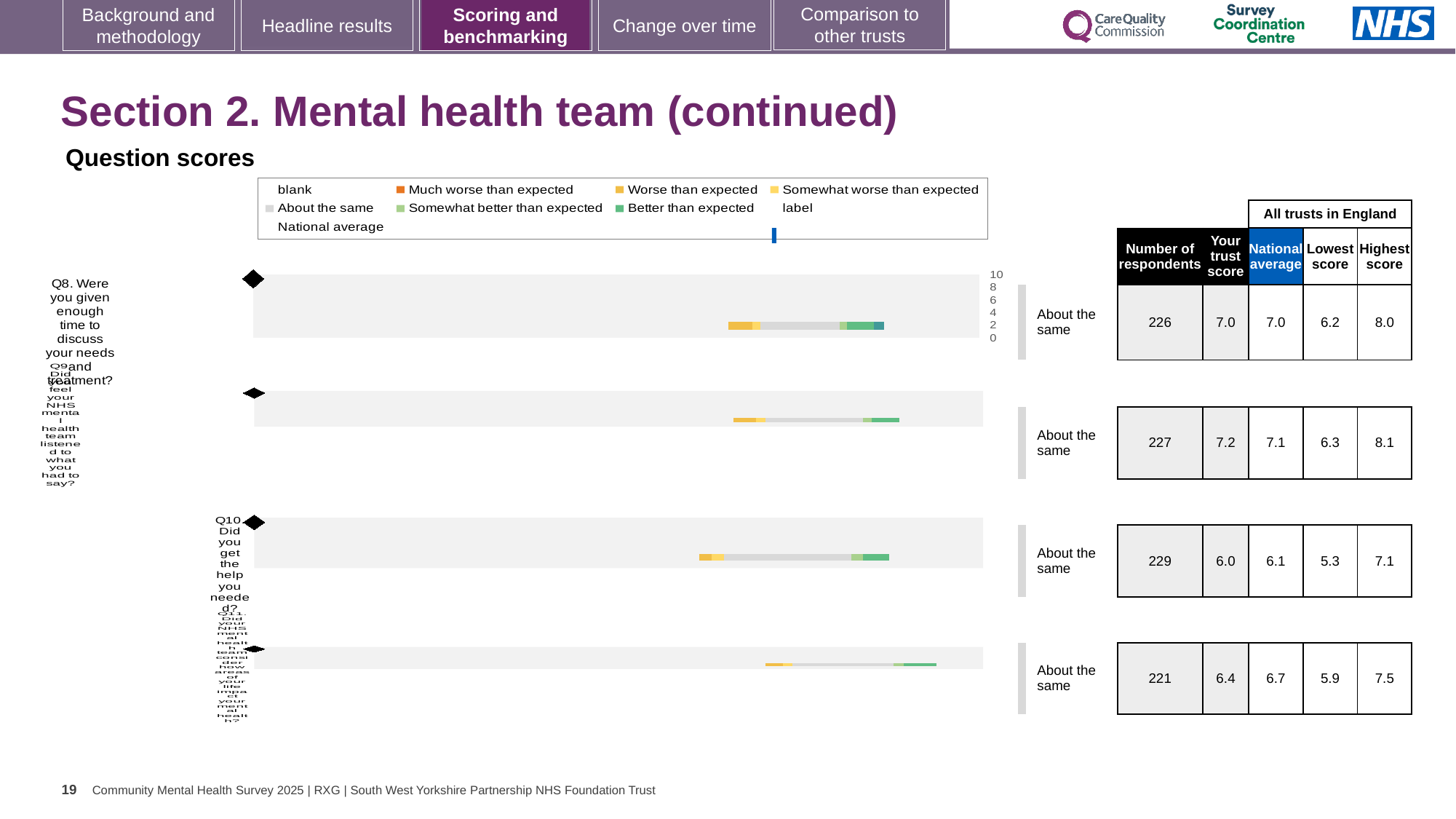
How many question rows are charted on this slide? 4 What is the highest score among all trusts in England for Q11 (the bottom chart row)? 7.5 Which question row has the lowest 'Your trust score'? Q10 What benchmark category is shown next to the Q8 chart? About the same What is the 'Your trust score' value for Q9 (the second chart row)? 7.2 How many respondents are shown for Q8 (Were you given enough time to discuss your needs and treatment?)? 226 For Q11, what is the difference between the national average and the trust score? 0.3 What is the national average for Q10 (Did you get the help you needed?)? 6.1 For Q9, which is larger: the trust score or the national average? Your trust score What kind of chart is used for each question row? Bar chart Which question row has the highest number of respondents? Q10 What is the lowest score among all trusts in England for Q10? 5.3